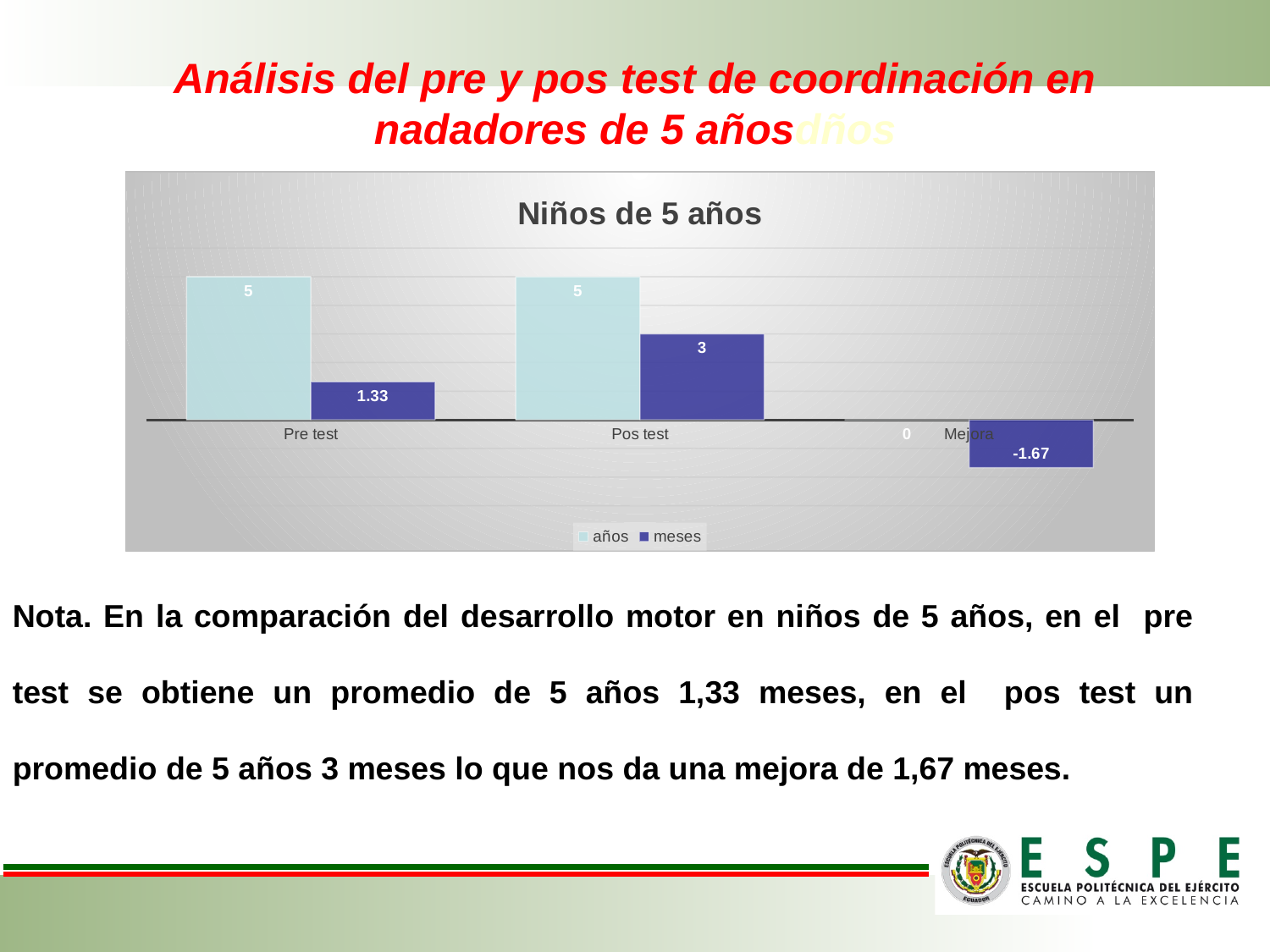
What is the value of the 'meses' series for Pre test? 1.33 What type of chart is shown on the slide? Bar chart How many series does the legend list? 2 What is the difference between the 'meses' value for Pos test and for Pre test? 1.67 What is the value of the 'meses' series for Mejora? -1.67 What is the value of the 'años' series for Mejora? 0 Which category has the highest 'meses' value? Pos test Which category has the lowest 'meses' value? Mejora How many categories are shown on the x axis? 3 What is the value of the 'meses' series for Pos test? 3 Is the 'meses' value larger for Pre test or for Pos test? Pos test What is the value of the 'años' series for Pre test? 5